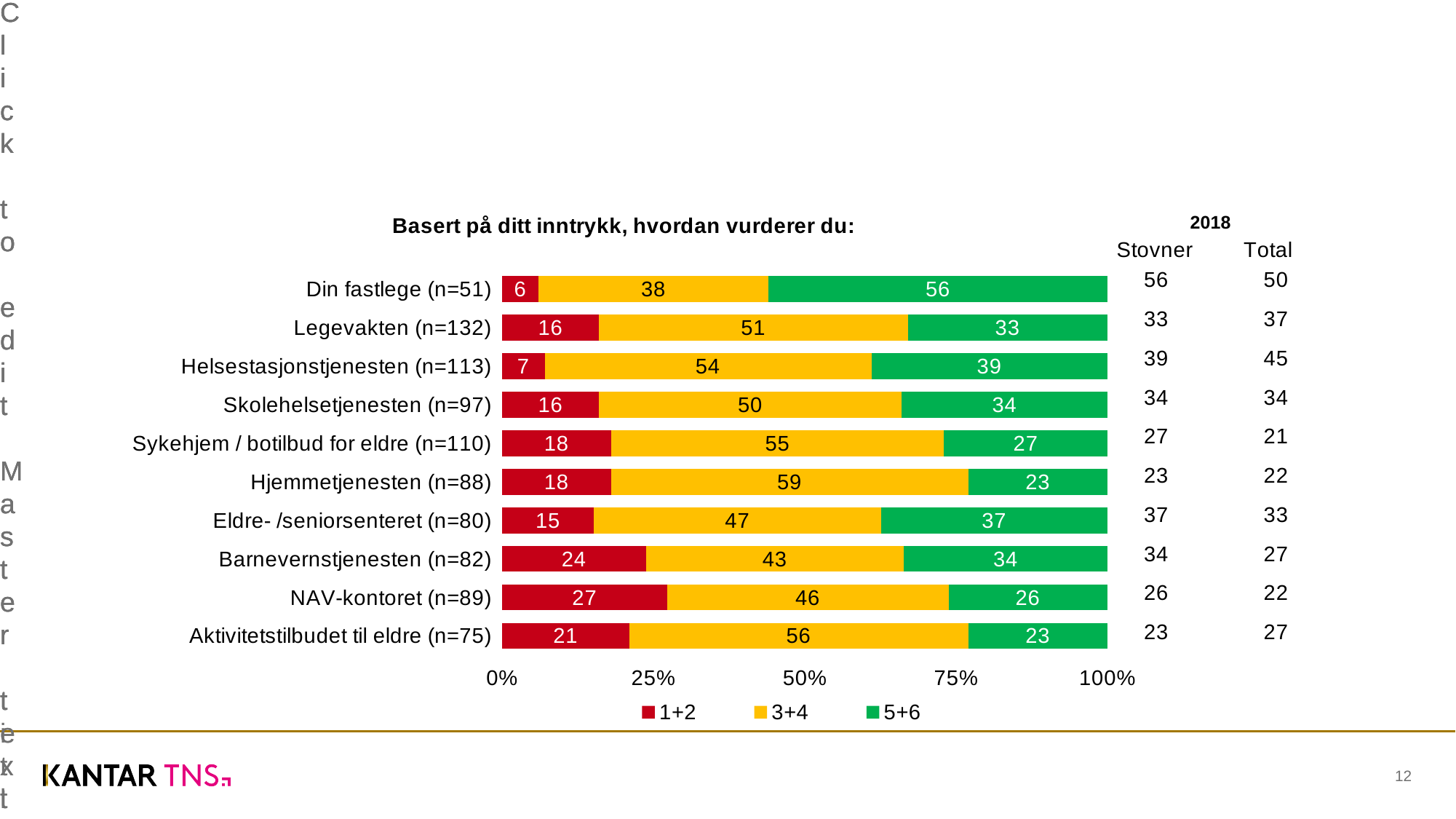
What is the total of the stacked bar for Din fastlege (n=51)? 100 What is the difference between the 5+6 values for Helsestasjonstjenesten (n=113) and Legevakten (n=132)? 6 Which has a larger 3+4 value, Sykehjem / botilbud for eldre (n=110) or Eldre- /seniorsenteret (n=80)? Sykehjem / botilbud for eldre (n=110) What is the 5+6 value for Din fastlege (n=51)? 56 Which category has the highest 1+2 value? NAV-kontoret (n=89) What is the 3+4 value for Hjemmetjenesten (n=88)? 59 How many categories are plotted in the chart? 10 Which category has the highest 5+6 value? Din fastlege (n=51) What is the 1+2 value for Barnevernstjenesten (n=82)? 24 Which category has the lowest 1+2 value? Din fastlege (n=51) What kind of chart is shown on the slide? Stacked bar chart How many series does the legend list? 3